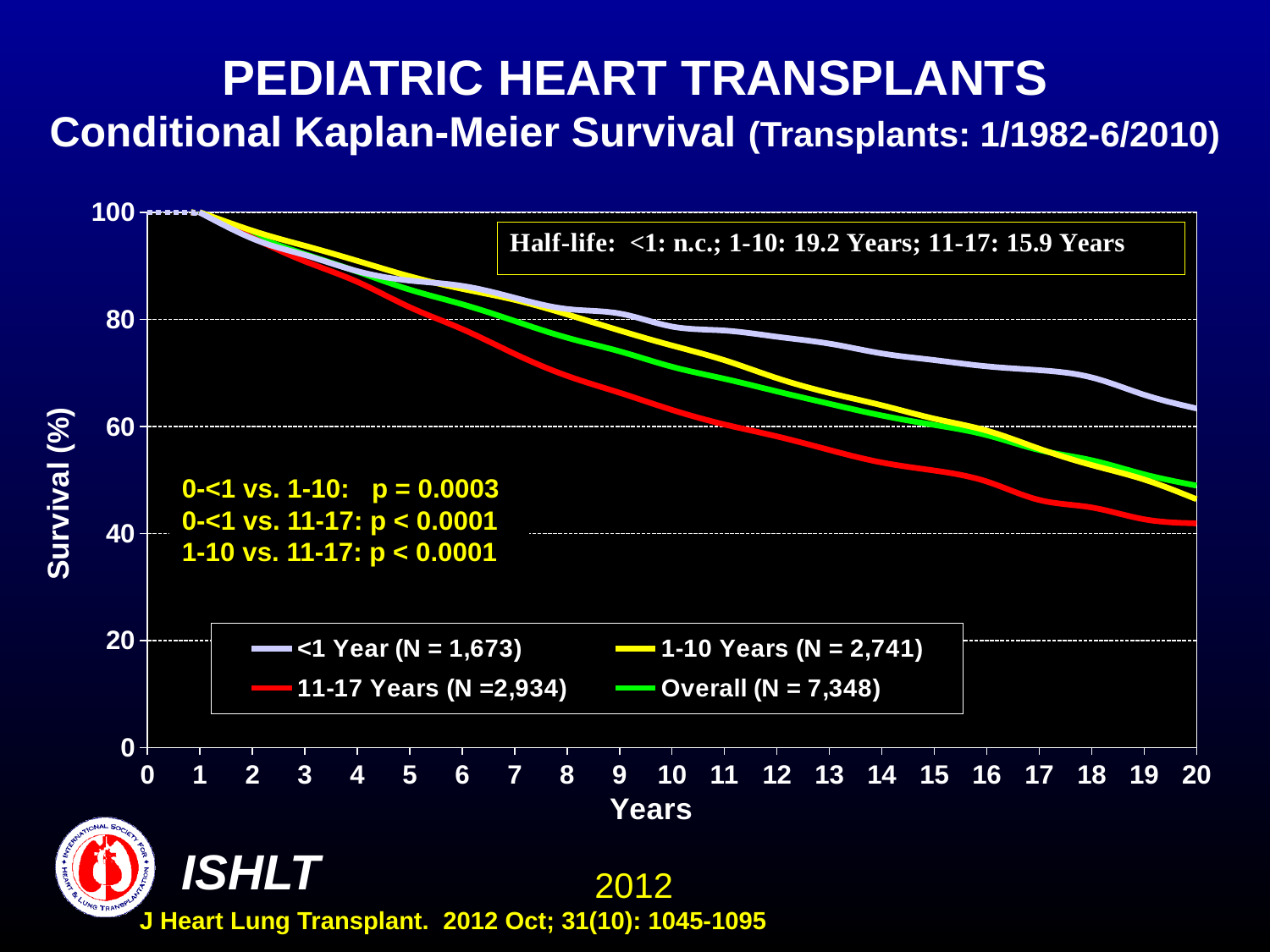
Is the survival for the 11-17 Years group at 15 years greater or less than 40? greater Is the survival for the 11-17 Years group at 20 years greater or less than 60? less Which series has the highest survival at 20 years? <1 Year At 20 years, is survival higher for the <1 Year group or the 11-17 Years group? <1 Year Which series has the lowest survival at 20 years? 11-17 Years What is the N for the Overall series in the legend? 7,348 Do the survival curves rise or fall as years increase? fall What half-life is reported for the 1-10 age group? 19.2 Years Is the survival for the 1-10 Years group at 20 years greater or less than 60? less How many series does the legend list? 4 What kind of chart is shown on the slide? line chart